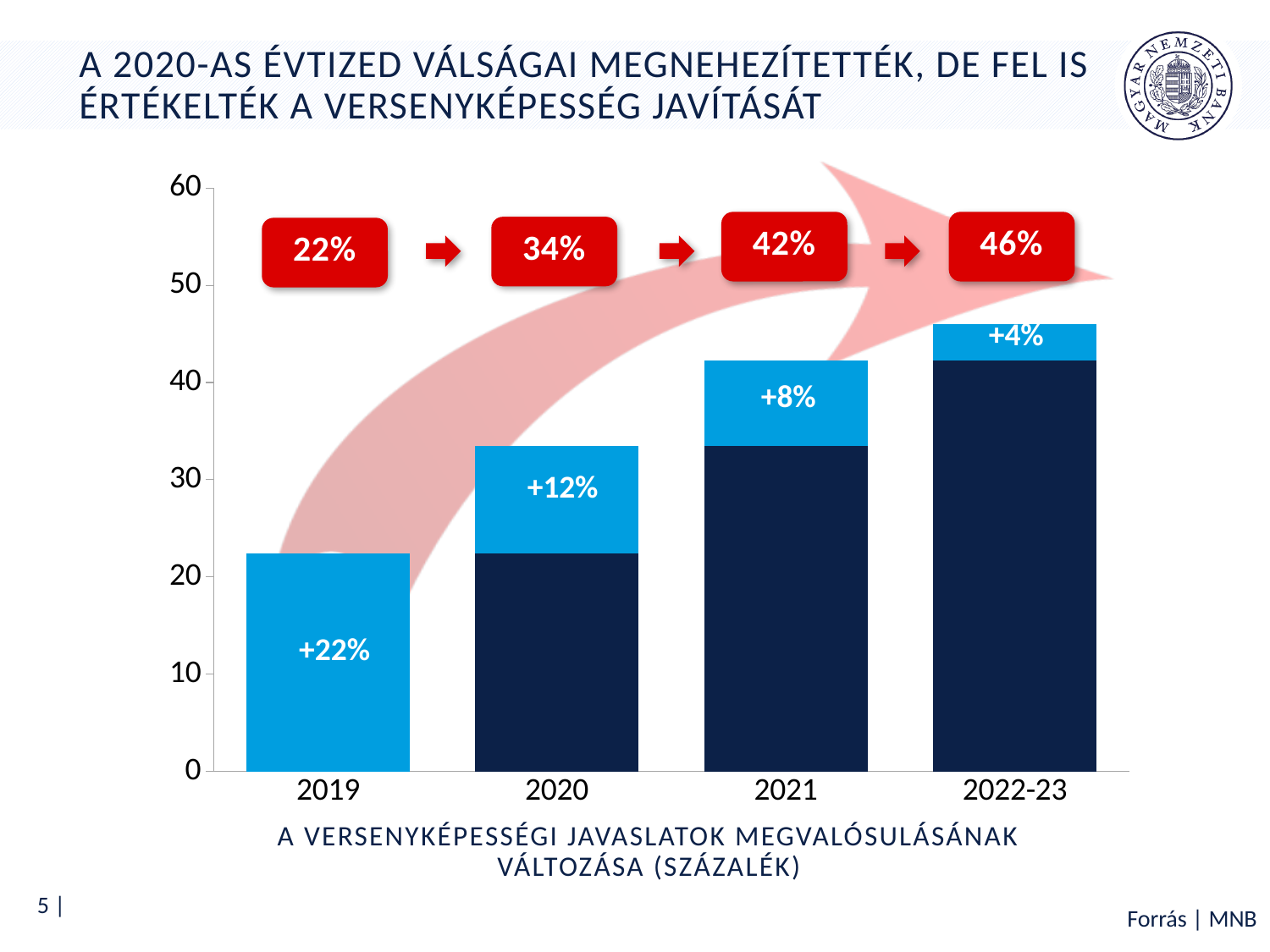
How many categories are shown on the x axis? 4 Do the bar totals rise or fall from 2019 to 2022-23? Rise What cumulative value is shown in the red box above the 2021 bar? 42% What is the increment labelled on the light blue segment for 2022-23? +4% What is the total of the stacked bar for 2020? 34% Is the total for 2021 greater or less than 40? greater What is the difference between the cumulative values shown for 2022-23 and 2019? 24 percentage points What is the increment labelled on the light blue segment for 2020? +12% Which is larger, the increment for 2020 or the increment for 2021? 2020 Which year has the tallest bar? 2022-23 Which year has the shortest bar? 2019 What kind of chart is shown on the slide? Stacked bar chart